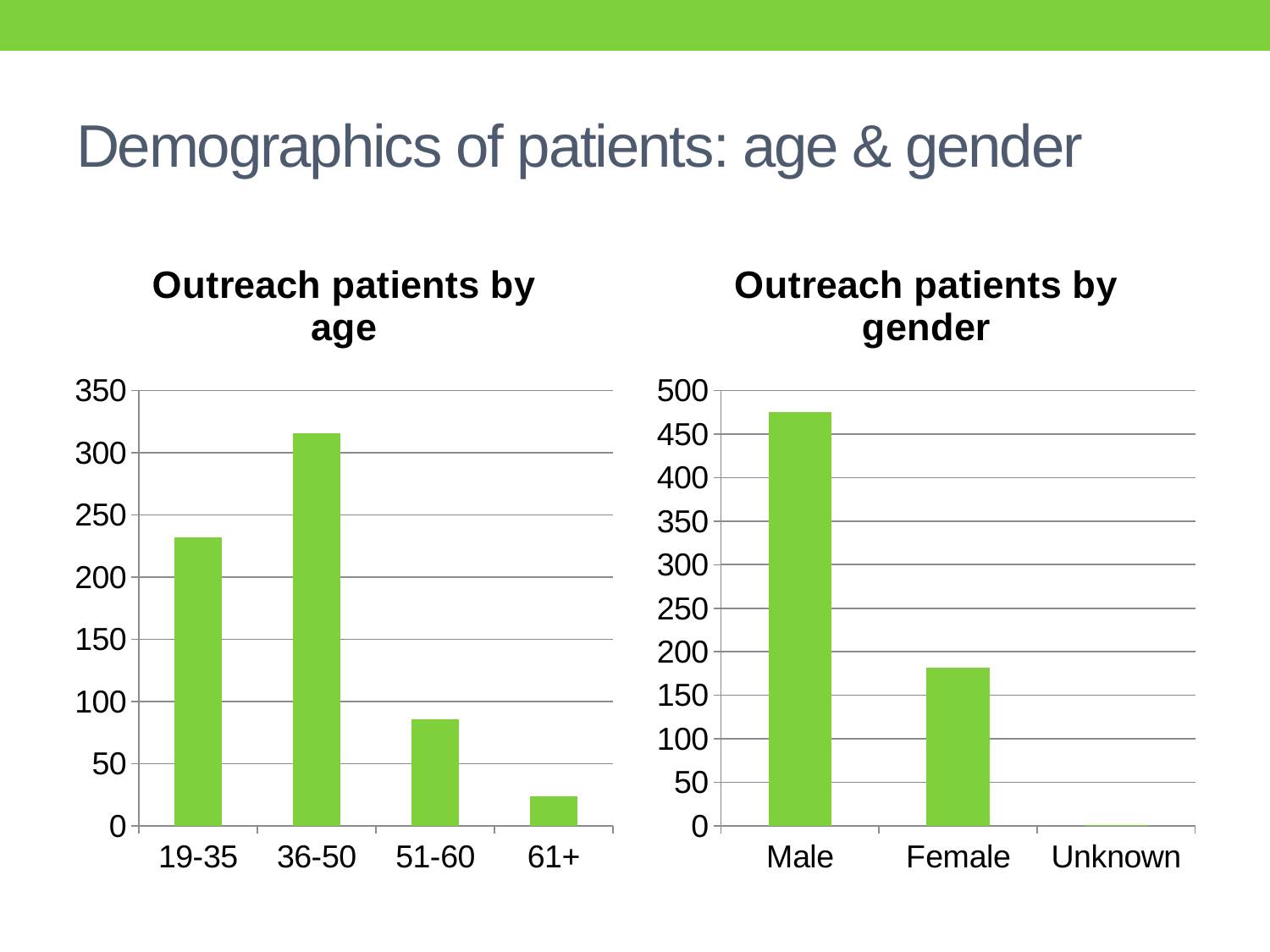
How many age groups are shown in the 'Outreach patients by age' chart? 4 In the 'Outreach patients by age' chart, which is larger, the value for 19-35 or the value for 51-60? 19-35 What type of chart is the 'Outreach patients by gender' chart? Bar chart In the 'Outreach patients by age' chart, which age group has the lowest number of patients? 61+ In the 'Outreach patients by age' chart, is the value for 19-35 greater or less than 200? greater In the 'Outreach patients by age' chart, is the value for 36-50 greater or less than 300? greater In the 'Outreach patients by gender' chart, is the value for Male greater or less than 450? greater How many categories are shown on the x axis of the 'Outreach patients by gender' chart? 3 In the 'Outreach patients by age' chart, which age group has the highest number of patients? 36-50 In the 'Outreach patients by gender' chart, which category has the highest number of patients? Male